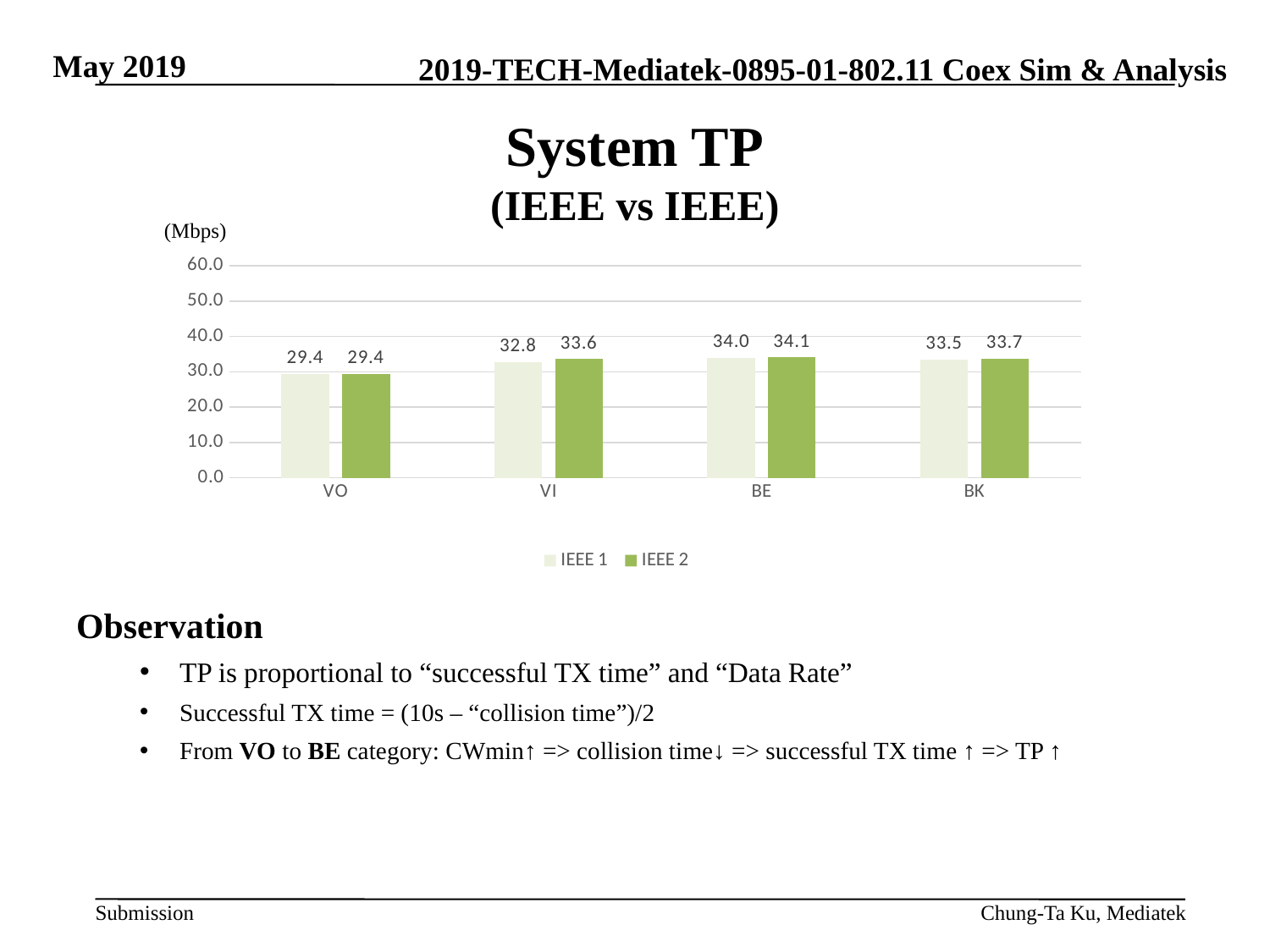
Which category has the lowest IEEE 2 value? VO What is the IEEE 2 value for VO? 29.4 What is the IEEE 1 value for VI? 32.8 For VI, which series has the larger value, IEEE 1 or IEEE 2? IEEE 2 How many series does the legend list? 2 What is the IEEE 2 value for BK? 33.7 Is the IEEE 1 value for VO greater or less than 40.0? less Which category has the highest IEEE 1 value? BE What kind of chart is shown on the slide? bar chart What is the difference between the IEEE 2 values for BE and VO? 4.7 How many categories are shown on the x axis? 4 What is the difference between the IEEE 2 and IEEE 1 values for VI? 0.8